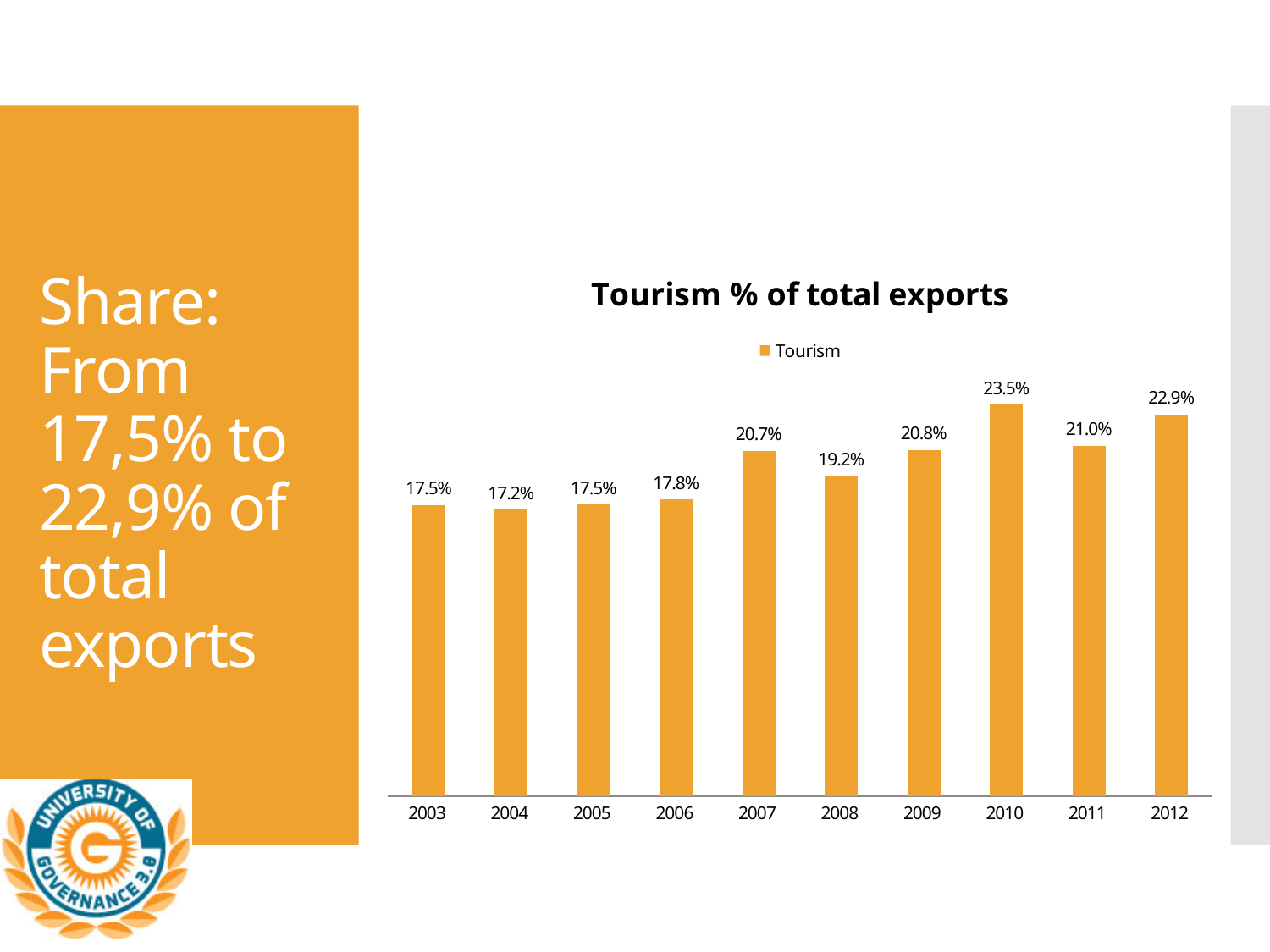
What is the tourism share of total exports in 2010? 23.5% How many series does the legend list? 1 What is the difference between the tourism share in 2010 and in 2011? 2.5% Which year has the lowest tourism share of total exports? 2004 Which year has the highest tourism share of total exports? 2010 What is the difference between the tourism share in 2012 and in 2003? 5.4% What is the tourism share of total exports in 2008? 19.2% What is the tourism share of total exports in 2004? 17.2% How many years are shown on the x axis of the chart? 10 What kind of chart is shown on the slide? Bar chart What is the title of the chart? Tourism % of total exports Which year has a larger tourism share of total exports, 2007 or 2008? 2007